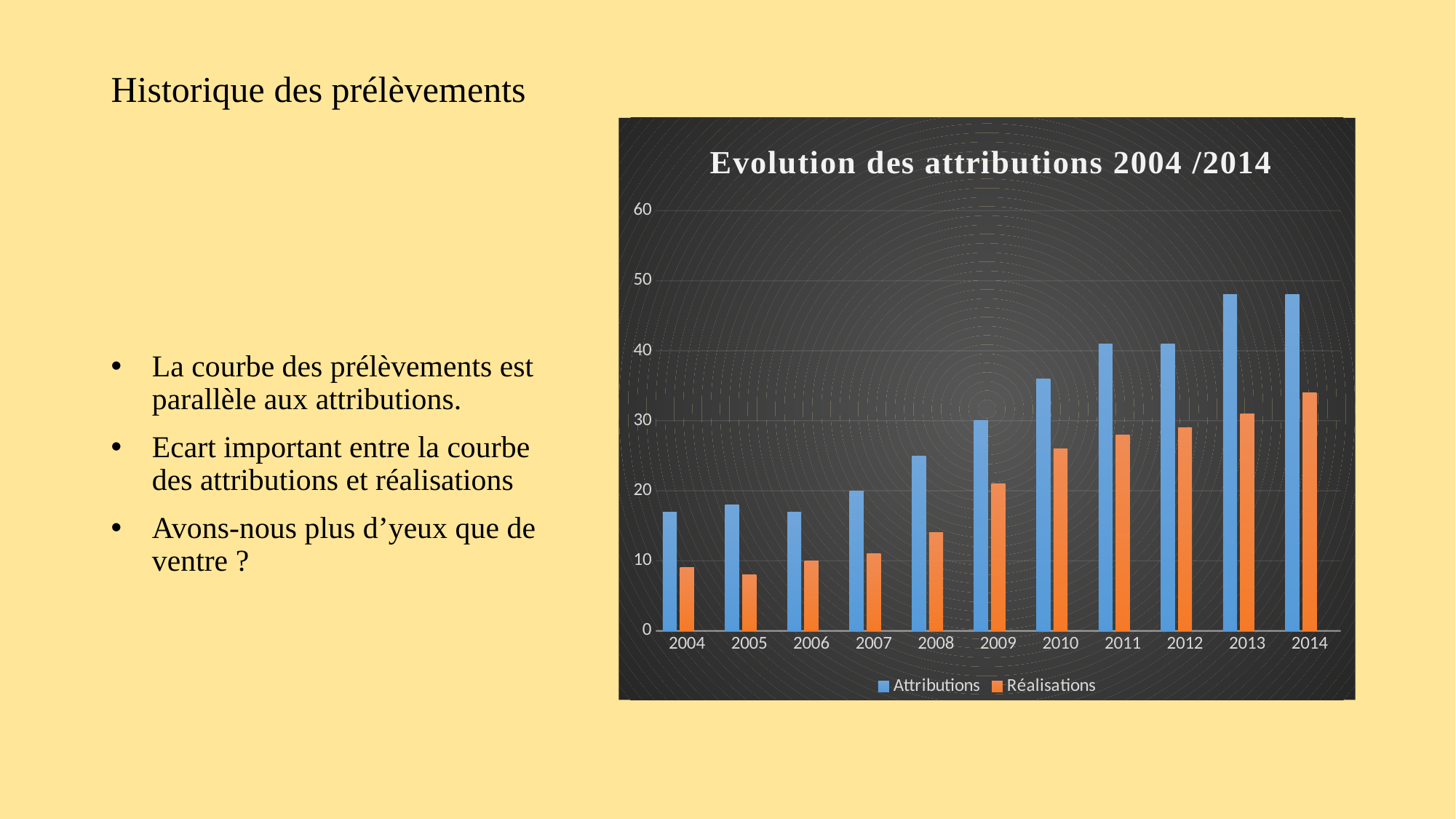
What is the title of the chart? Evolution des attributions 2004 /2014 Is the value for Réalisations in 2008 greater or less than 20? less What kind of chart is shown on the slide? bar chart Which year has the highest value for Réalisations? 2014 In 2011, which is larger: Attributions or Réalisations? Attributions Is the value for Attributions in 2013 greater or less than 50? less How many series does the legend list? 2 Do the Réalisations values generally rise or fall from 2004 to 2014? rise How many years are shown on the x axis of the chart? 11 Which series is shown in orange? Réalisations Is the value for Attributions in 2010 greater or less than 30? greater